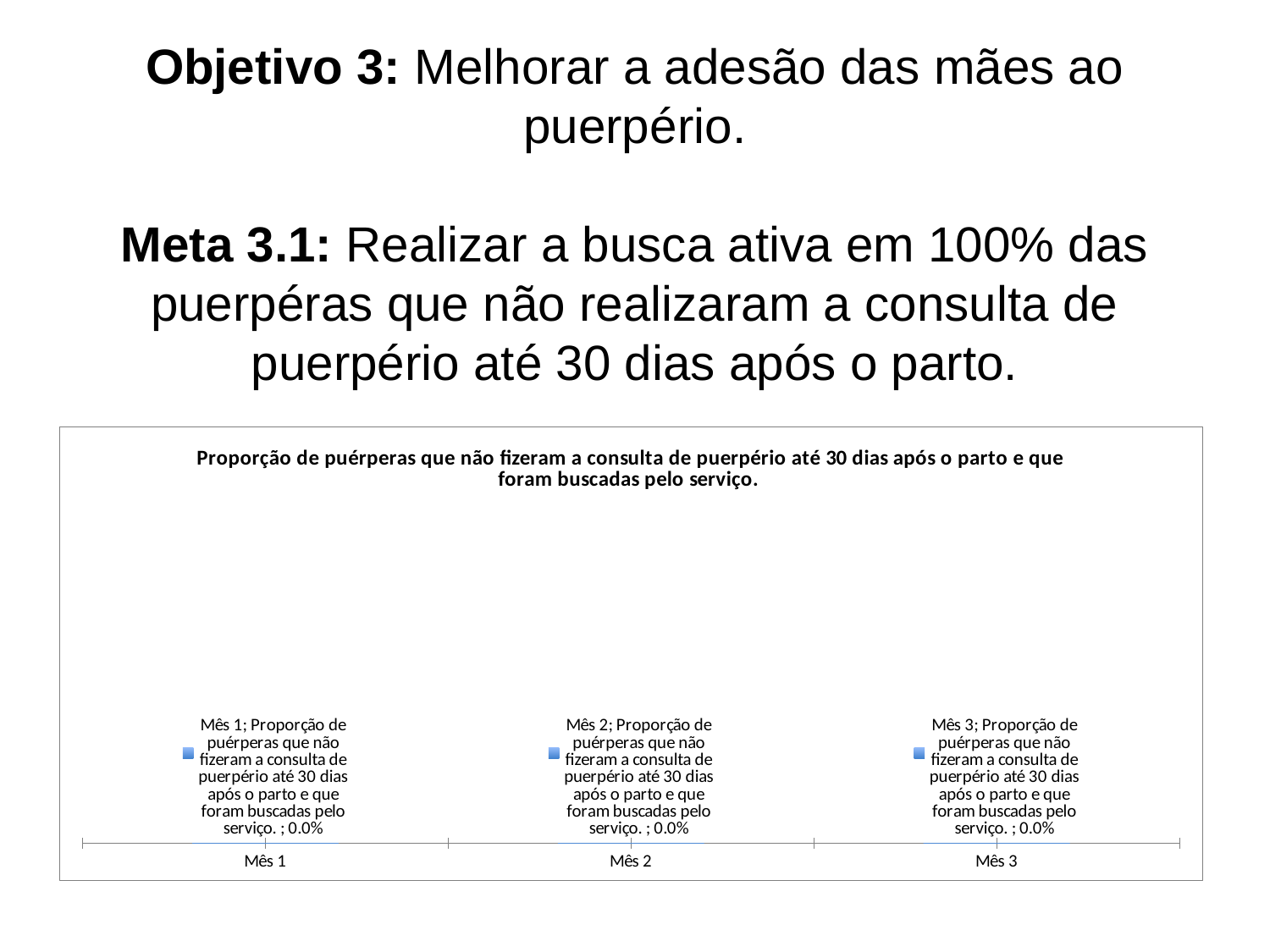
What is the value for Mês 1? 0.0% What is the title of the chart? Proporção de puérperas que não fizeram a consulta de puerpério até 30 dias após o parto e que foram buscadas pelo serviço. What is the label of the first category on the x axis? Mês 1 How many categories are shown on the x axis of the chart? 3 What kind of chart is shown on the slide? bar chart What is the difference between the values for Mês 1 and Mês 3? 0.0% What is the value for Mês 2? 0.0% What is the value for Mês 3? 0.0% Do the values rise, fall, or stay the same from Mês 1 to Mês 3? stay the same